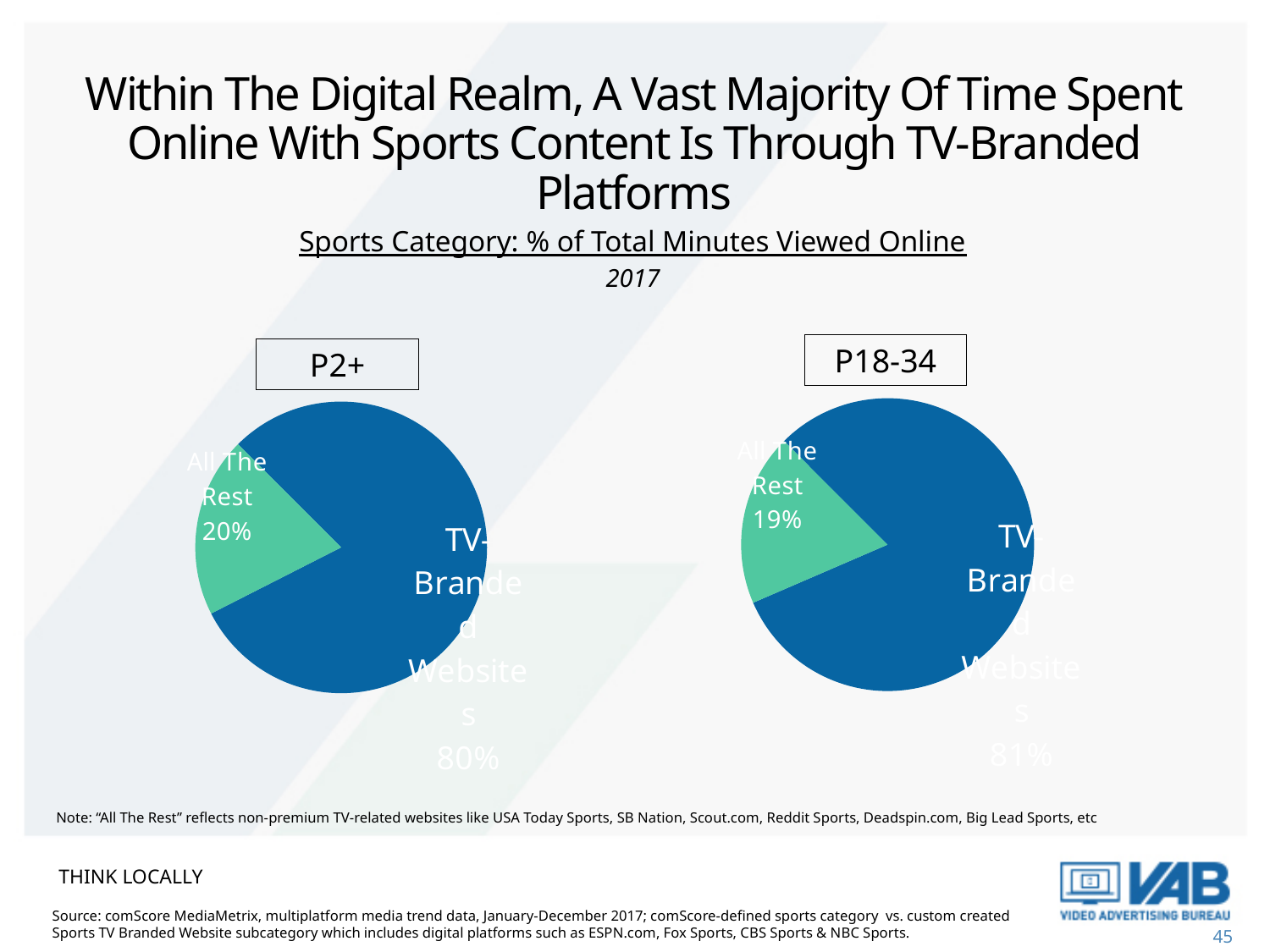
In the P2+ pie chart, what share of total minutes viewed online is attributed to All The Rest? 20% In the P18-34 pie chart, what share is attributed to All The Rest? 19% What year does the data on the slide cover? 2017 What type of chart is used on this slide for the P2+ and P18-34 data? Pie chart In the P18-34 pie chart, what share is attributed to TV-Branded Websites? 81% In the P18-34 pie chart, which slice is the smallest? All The Rest How many slices does the P18-34 pie chart have? 2 Is the All The Rest share larger in the P2+ chart or the P18-34 chart? P2+ In the P2+ pie chart, which slice is the largest? TV-Branded Websites What is the subtitle describing the measure shown in the pie charts? Sports Category: % of Total Minutes Viewed Online In the P2+ pie chart, what share is attributed to TV-Branded Websites? 80% In the P2+ pie chart, what is the difference in percentage points between TV-Branded Websites and All The Rest? 60 percentage points